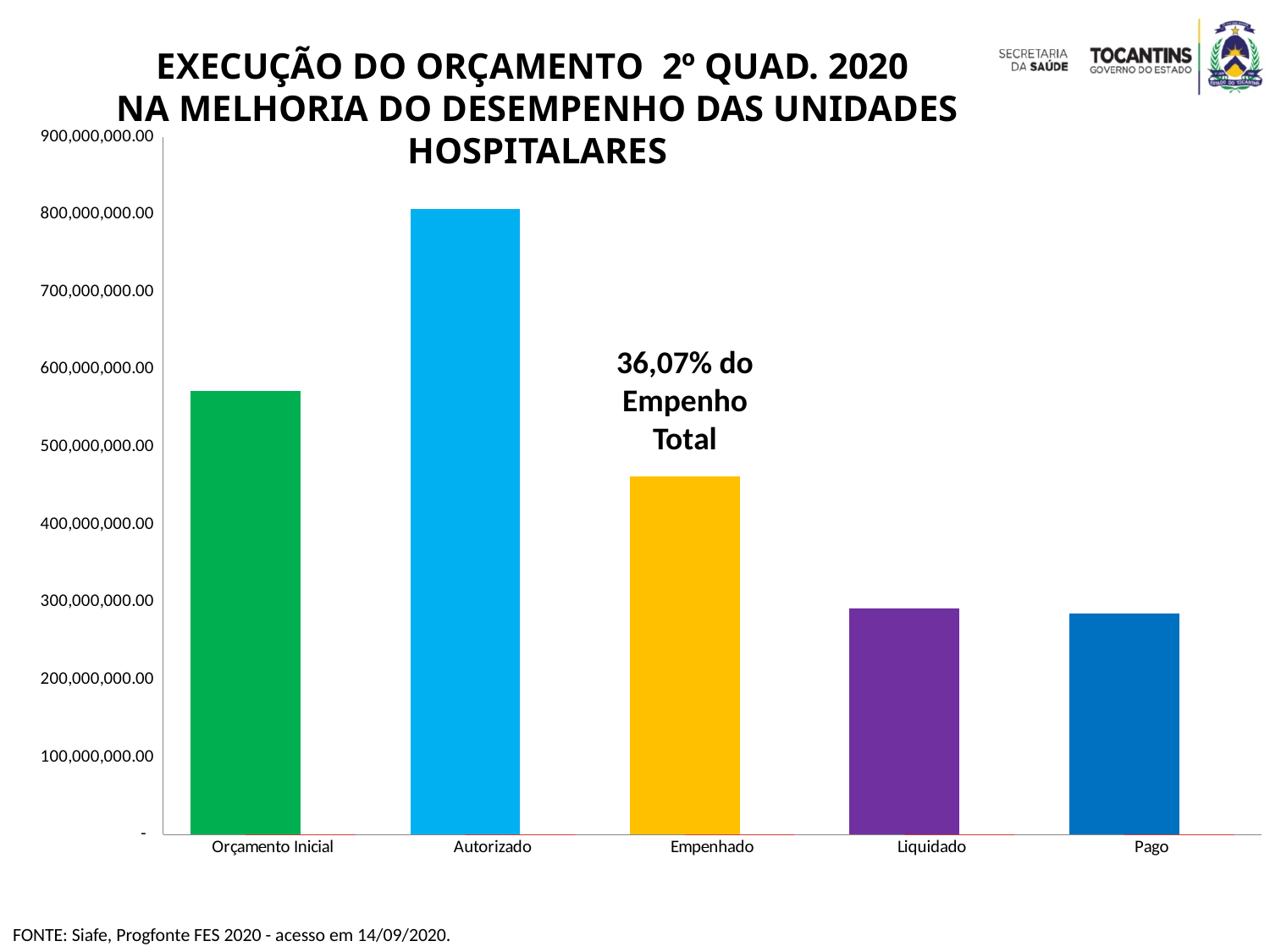
Which category has the highest bar? Autorizado What percentage is stated in the annotation above the Empenhado bar? 36,07% Which is larger, the value for Autorizado or the value for Orçamento Inicial? Autorizado Is the value for Liquidado greater or less than 200,000,000.00? greater Which is larger, the value for Empenhado or the value for Liquidado? Empenhado What kind of chart is shown on the slide? bar chart Is the value for Autorizado greater or less than 700,000,000.00? greater Is the value for Pago greater or less than 300,000,000.00? less What is the highest value shown on the y axis? 900,000,000.00 How many categories are plotted on the x axis? 5